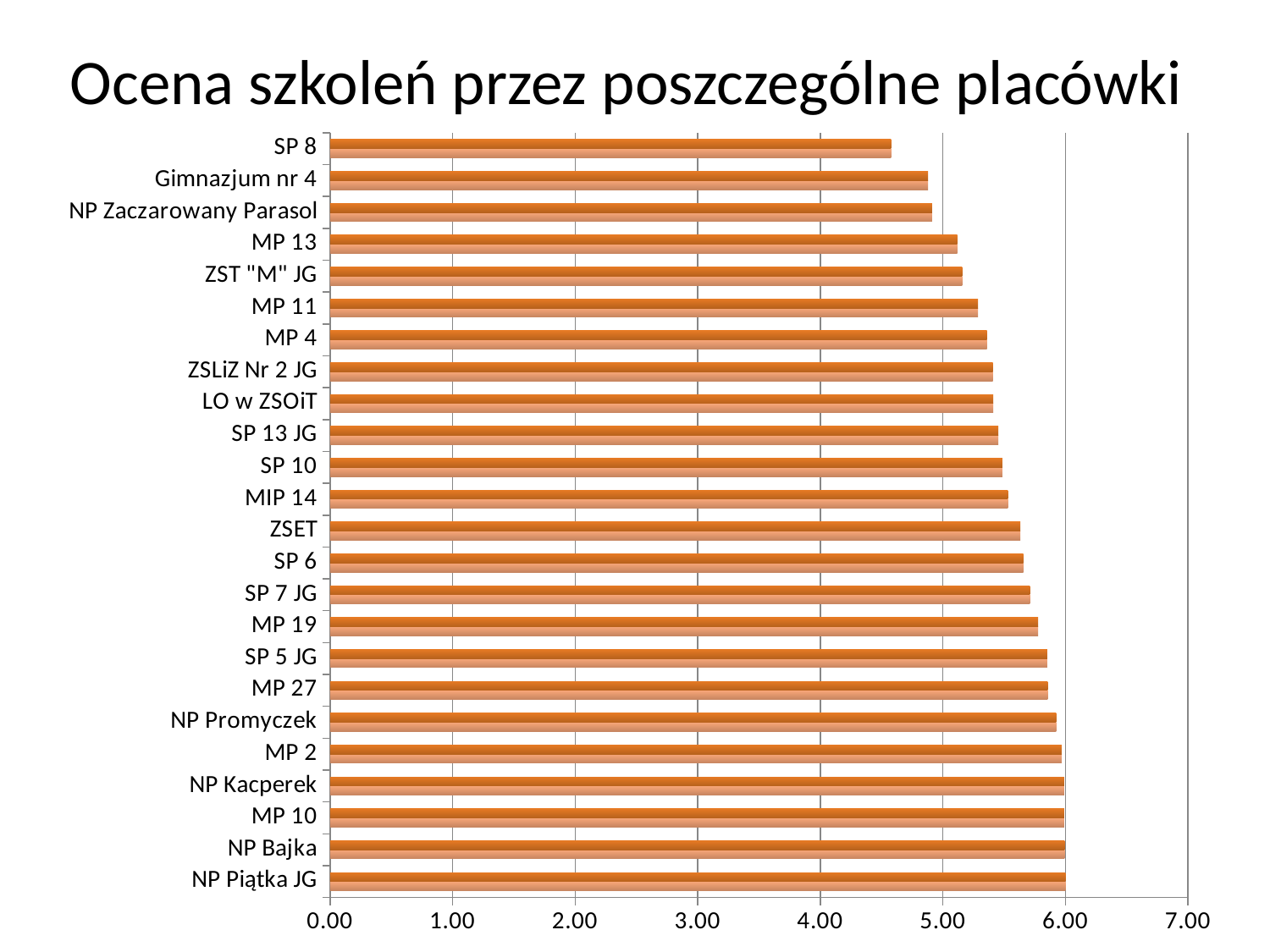
Is the value for SP 6 greater or less than 5.00? greater What kind of chart is shown on the slide? bar chart Which has a higher rating, SP 8 or MP 2? MP 2 Is the value for MP 19 greater or less than 6.00? less Is the value for SP 8 greater or less than 5.00? less Which institution has the lowest rating on the chart? SP 8 What is the value for NP Piątka JG? 6.00 How many institutions (categories) are listed on the chart? 24 What is the title of the chart? Ocena szkoleń przez poszczególne placówki Which has a higher rating, MP 13 or SP 7 JG? SP 7 JG